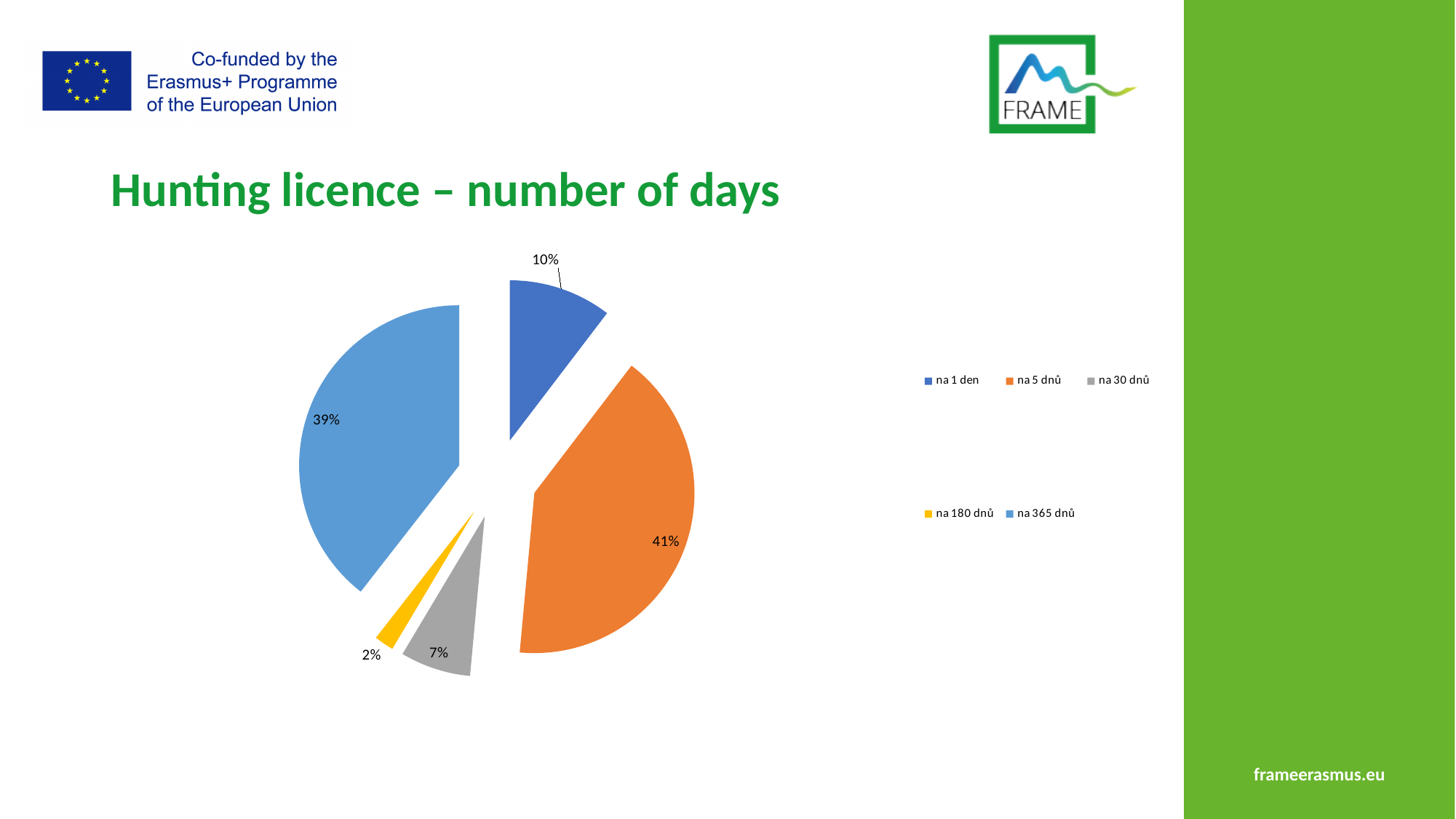
What is the difference between the shares of "na 5 dnů" and "na 365 dnů"? 2% What share of the pie does "na 5 dnů" take? 41% How many slices does the pie chart have? 5 What kind of chart is shown on the slide? pie chart What is the value for "na 180 dnů"? 2% What share of the pie does "na 365 dnů" take? 39% Which is larger, the share for "na 1 den" or the share for "na 30 dnů"? na 1 den Which category has the largest slice of the pie? na 5 dnů What is the title of the slide containing the chart? Hunting licence – number of days What is the value for "na 1 den"? 10% Which category has the smallest slice of the pie? na 180 dnů What is the value for "na 30 dnů"? 7%